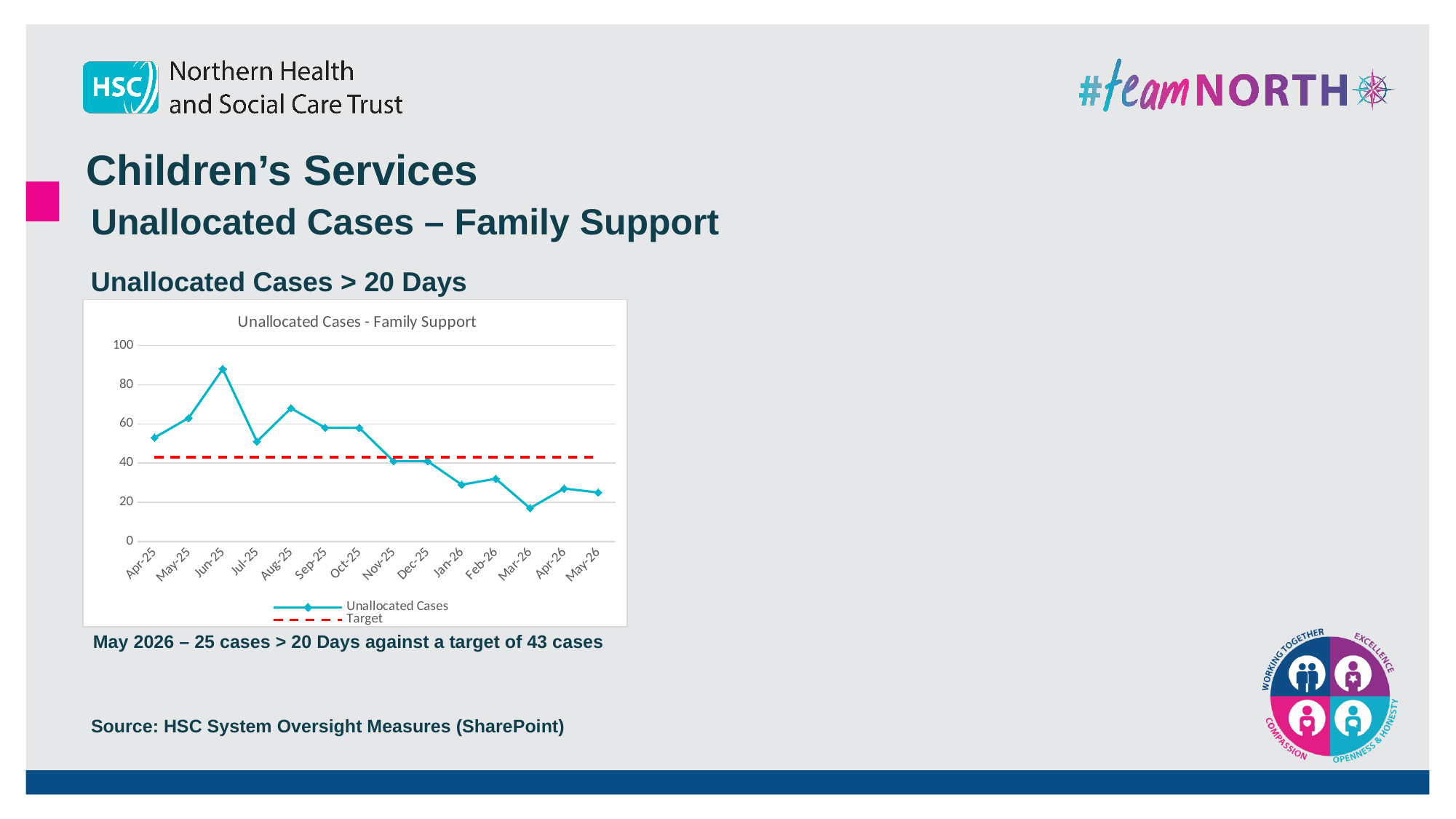
What is the target value shown by the dashed line? 43 How many series does the chart legend list? 2 Is the value for Mar-26 greater or less than 20? less Overall, do unallocated cases rise or fall from Apr-25 to May-26? Fall What kind of chart is shown on the slide? Line chart In which month is the number of unallocated cases lowest? Mar-26 What is the title of the chart? Unallocated Cases - Family Support How many months are plotted along the x axis of the chart? 14 Which month has more unallocated cases, Jun-25 or Jul-25? Jun-25 Is the value for Jun-25 greater or less than 80? greater In which month is the number of unallocated cases highest? Jun-25 What is the number of unallocated cases > 20 days for May-26? 25